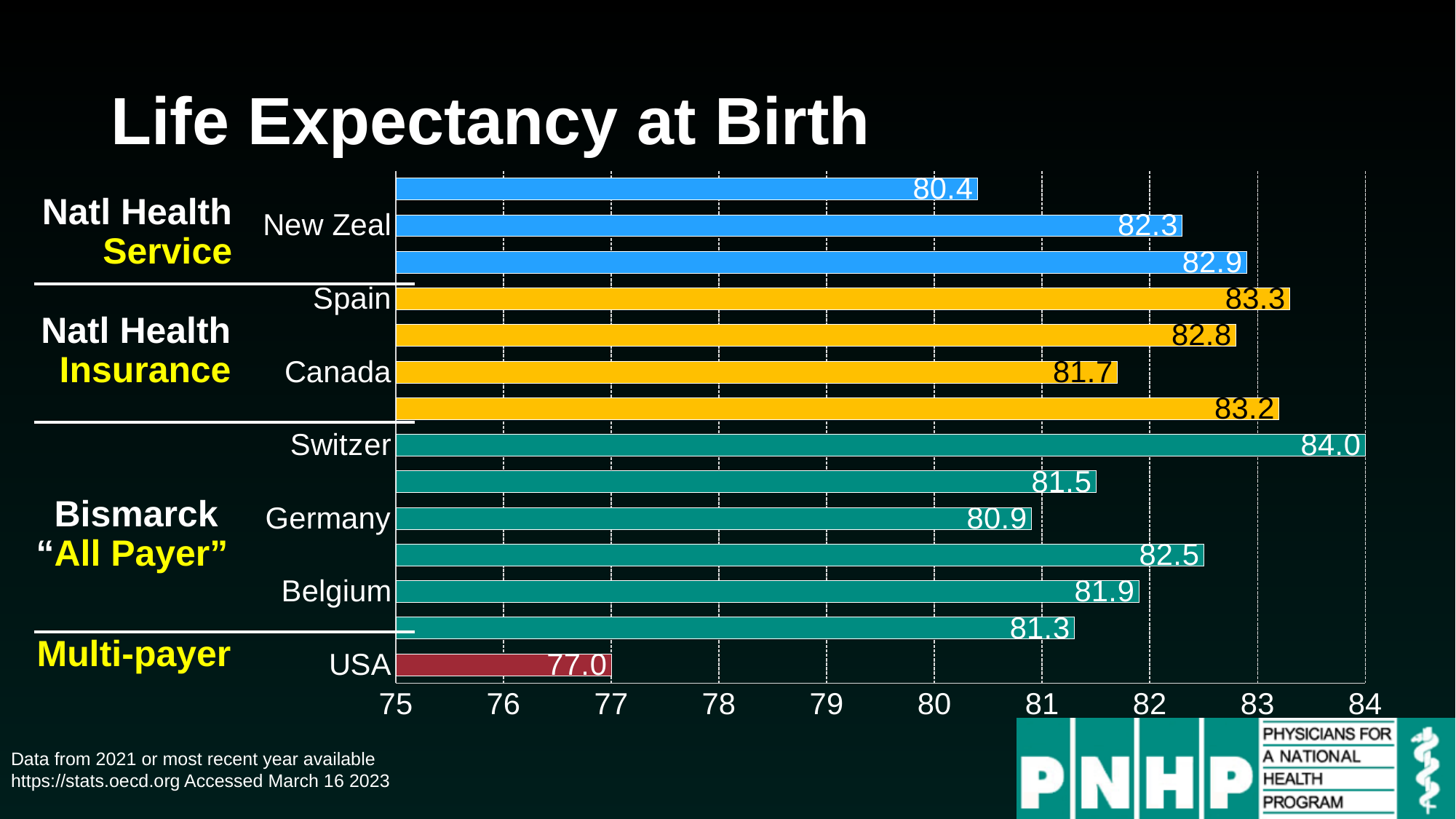
What is the difference in life expectancy at birth between Spain and the USA? 6.3 What colour is the bar for the USA? Red Which country has the lowest life expectancy at birth on the chart? USA What is the life expectancy at birth shown for Belgium? 81.9 What is the life expectancy at birth shown for Spain? 83.3 What is the life expectancy at birth shown for Germany? 80.9 What kind of chart is shown on the slide? Bar chart What is the life expectancy at birth shown for Canada? 81.7 Which labelled country has the highest life expectancy at birth on the chart? Switzer Which has a higher life expectancy at birth, Canada or Belgium? Belgium What is the life expectancy at birth shown for the USA? 77.0 How many bars are plotted on the chart? 14